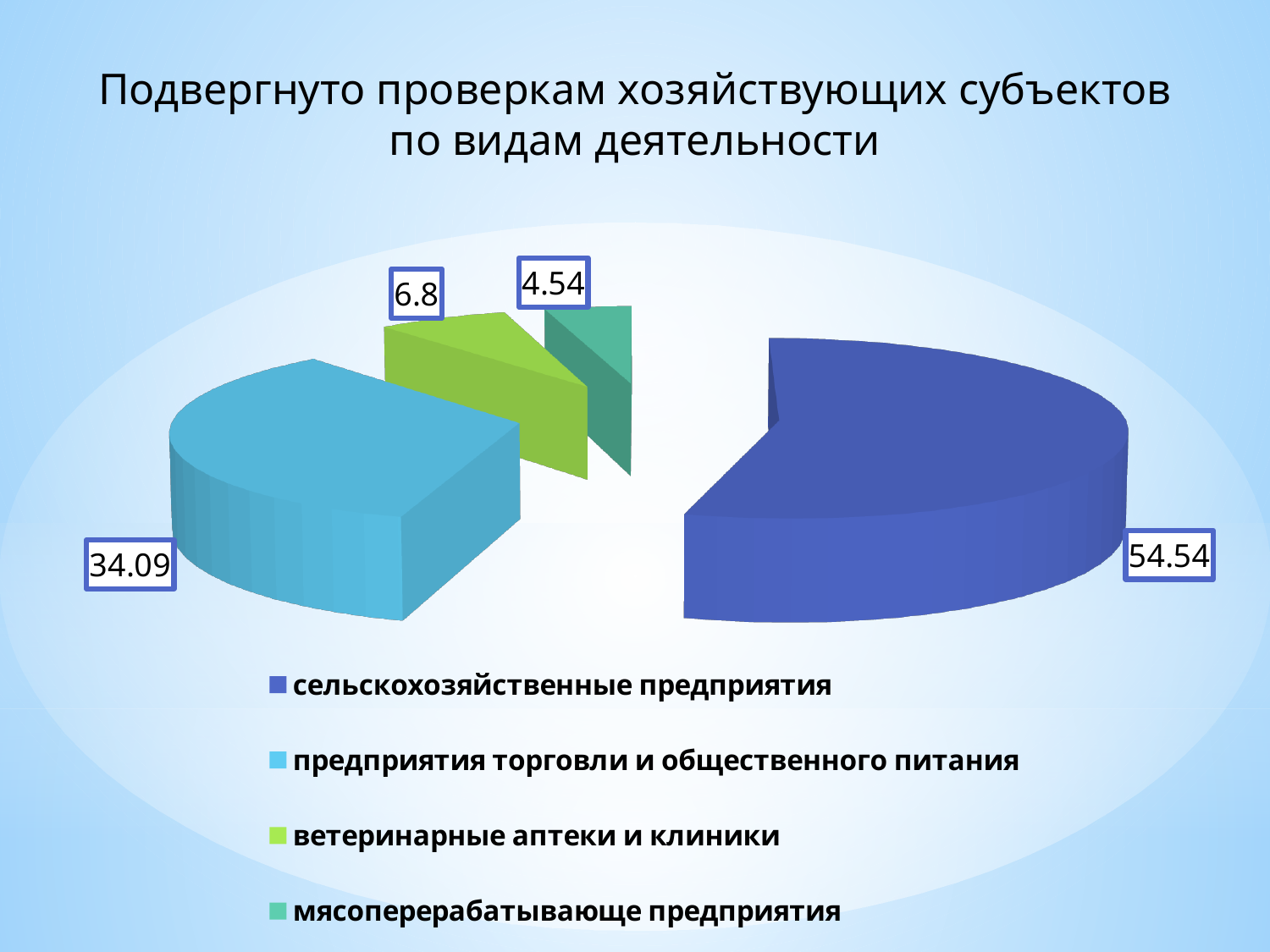
What is the value for сельскохозяйственные предприятия? 54.54 How many categories does the pie chart have? 4 What is the title of the chart? Подвергнуто проверкам хозяйствующих субъектов по видам деятельности What type of chart is shown on the slide? Pie chart What is the difference between the values for ветеринарные аптеки и клиники and мясоперерабатывающе предприятия? 2.26 What is the value for мясоперерабатывающе предприятия? 4.54 Which category has the largest slice of the pie? сельскохозяйственные предприятия What is the difference between the values for сельскохозяйственные предприятия and предприятия торговли и общественного питания? 20.45 Which is larger: the value for предприятия торговли и общественного питания or the value for ветеринарные аптеки и клиники? предприятия торговли и общественного питания Which category has the smallest slice of the pie? мясоперерабатывающе предприятия What is the value for ветеринарные аптеки и клиники? 6.8 What is the value for предприятия торговли и общественного питания? 34.09